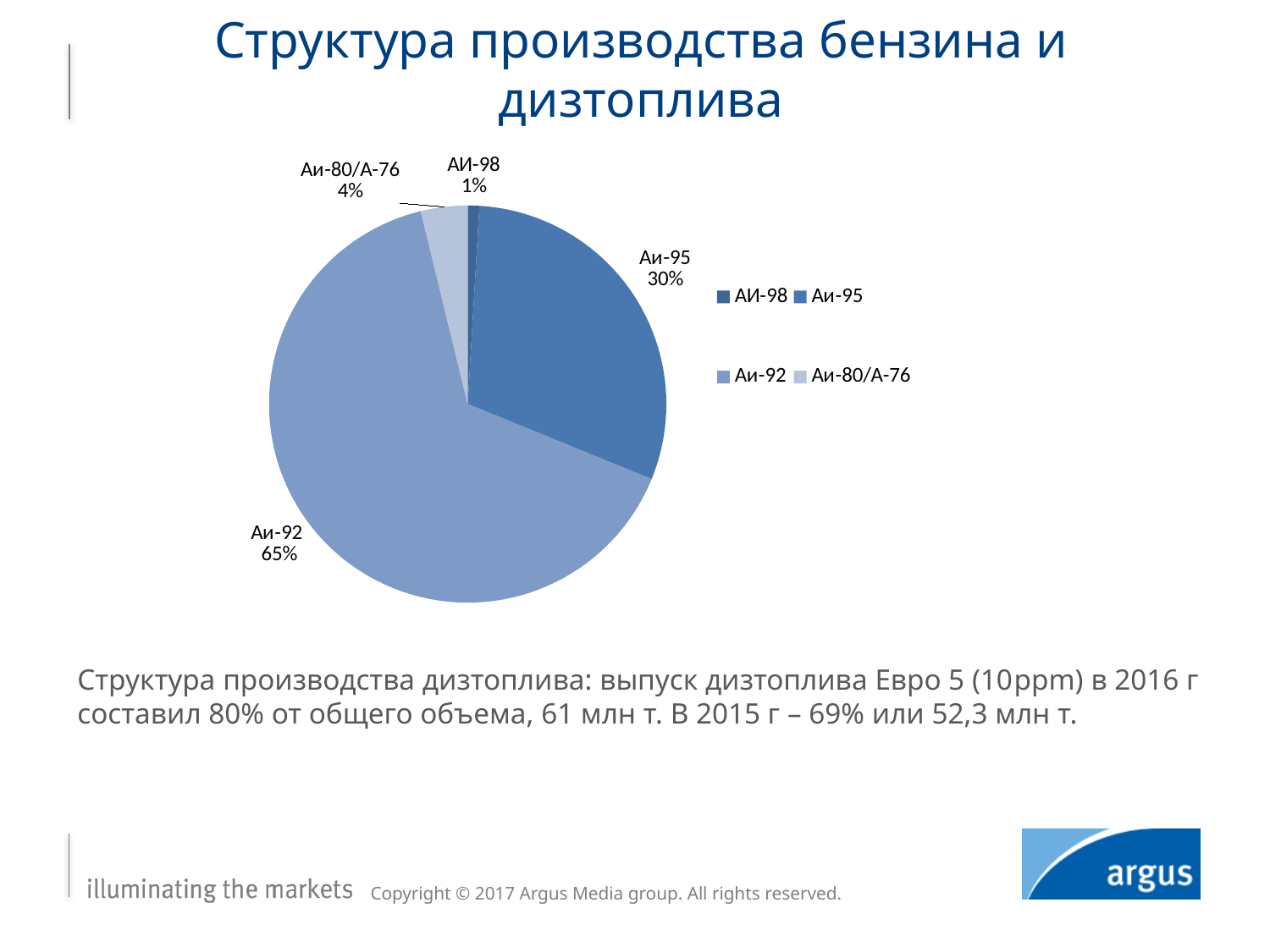
What share of the pie does Аи-80/А-76 have? 4% Which category has the largest slice of the pie? Аи-92 Which slice is larger, Аи-95 or Аи-80/А-76? Аи-95 Which category has the smallest slice of the pie? АИ-98 What share of the pie does Аи-95 have? 30% How many slices does the pie chart have? 4 How many entries does the legend list? 4 What kind of chart is shown on the slide? pie chart What is the title of the slide containing the pie chart? Структура производства бензина и дизтоплива What share of the pie does АИ-98 have? 1% What is the difference in percentage points between the Аи-92 and Аи-95 slices? 35 What share of the pie does Аи-92 have? 65%